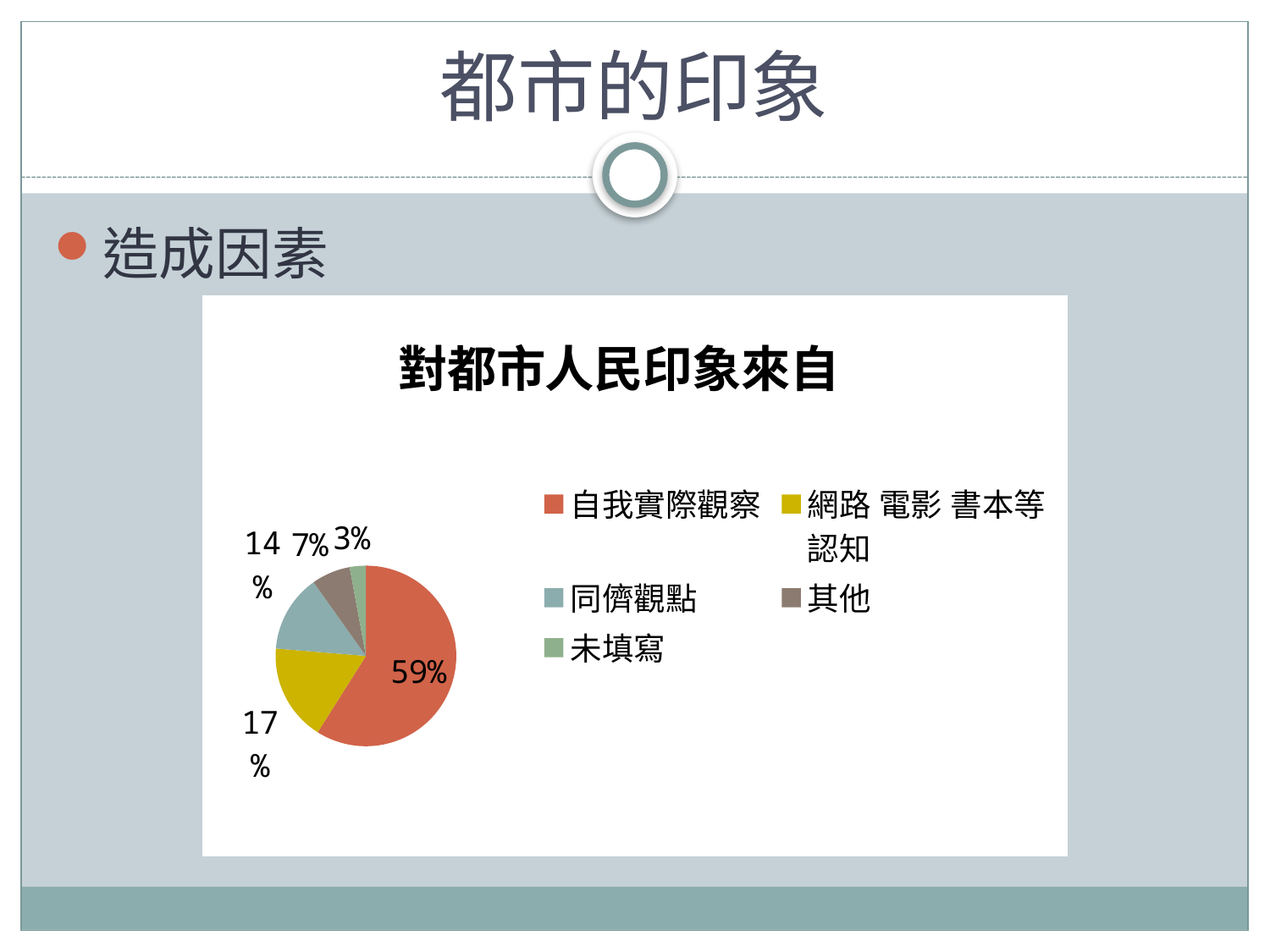
Which category has the largest share of the pie? 自我實際觀察 What is the title of the chart? 對都市人民印象來自 What percentage of the pie is 未填寫? 3% What percentage of the pie is 同儕觀點? 14% Which category has the smallest share of the pie? 未填寫 How many categories does the legend list? 5 What percentage of the pie is 網路 電影 書本等認知? 17% What percentage of the pie is 其他? 7% What is the difference in percentage points between 自我實際觀察 and 網路 電影 書本等認知? 42 What percentage of the pie is 自我實際觀察? 59% Which is larger, the share for 同儕觀點 or the share for 其他? 同儕觀點 What type of chart is shown on the slide? pie chart